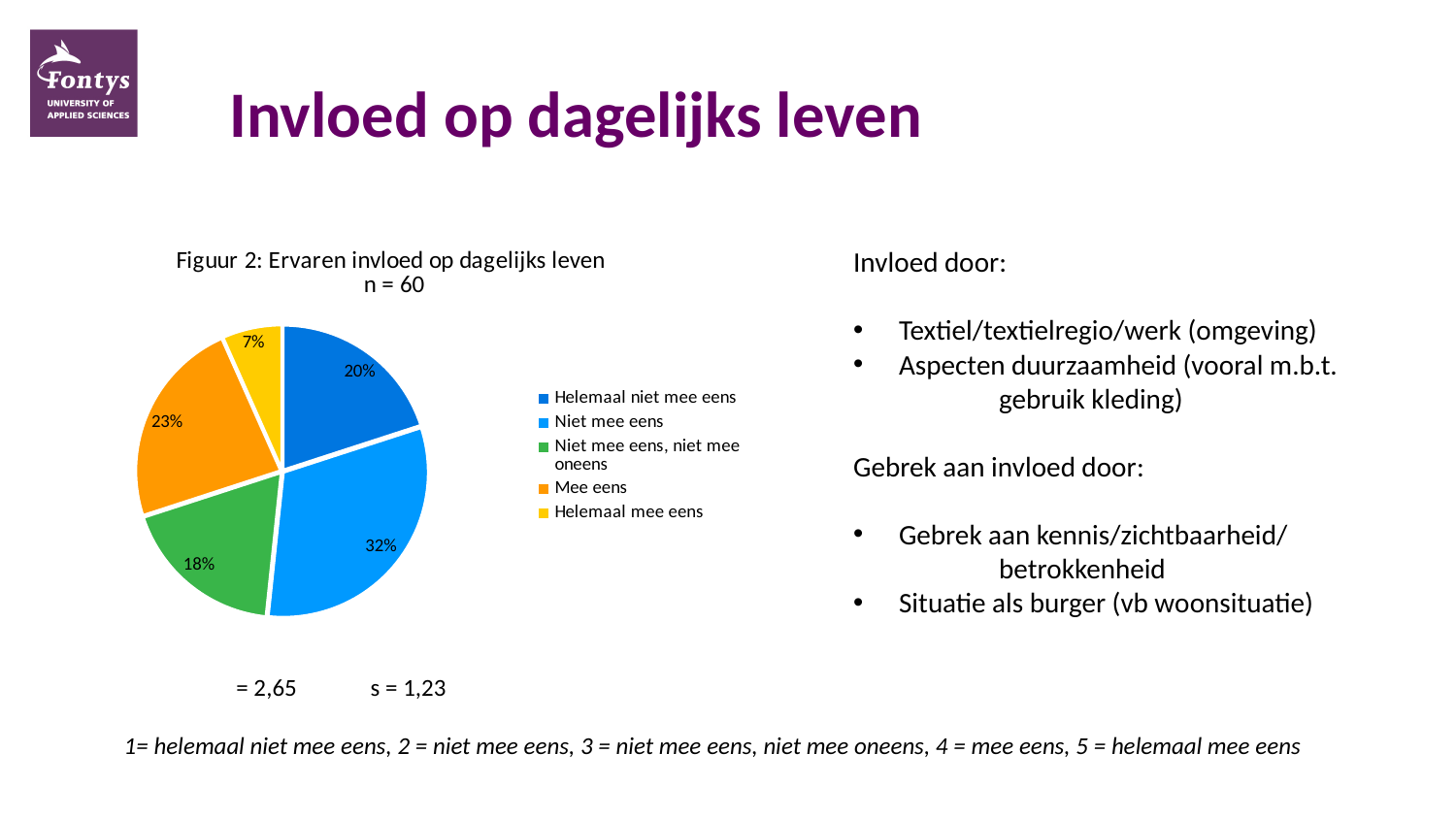
What kind of chart is shown on the slide? Pie chart What percentage of the pie is 'Helemaal niet mee eens'? 20% What colour is the 'Niet mee eens, niet mee oneens' slice? Green What is the difference in percentage points between 'Niet mee eens' and 'Niet mee eens, niet mee oneens'? 14 What percentage of the pie is 'Mee eens'? 23% What percentage of the pie is 'Helemaal mee eens'? 7% What percentage of the pie is 'Niet mee eens'? 32% What is the title of the chart? Figuur 2: Ervaren invloed op dagelijks leven n = 60 Which category has the largest share of the pie? Niet mee eens Which category has the smallest share of the pie? Helemaal mee eens How many categories does the legend list? 5 Which is larger: the share for 'Mee eens' or the share for 'Helemaal niet mee eens'? Mee eens